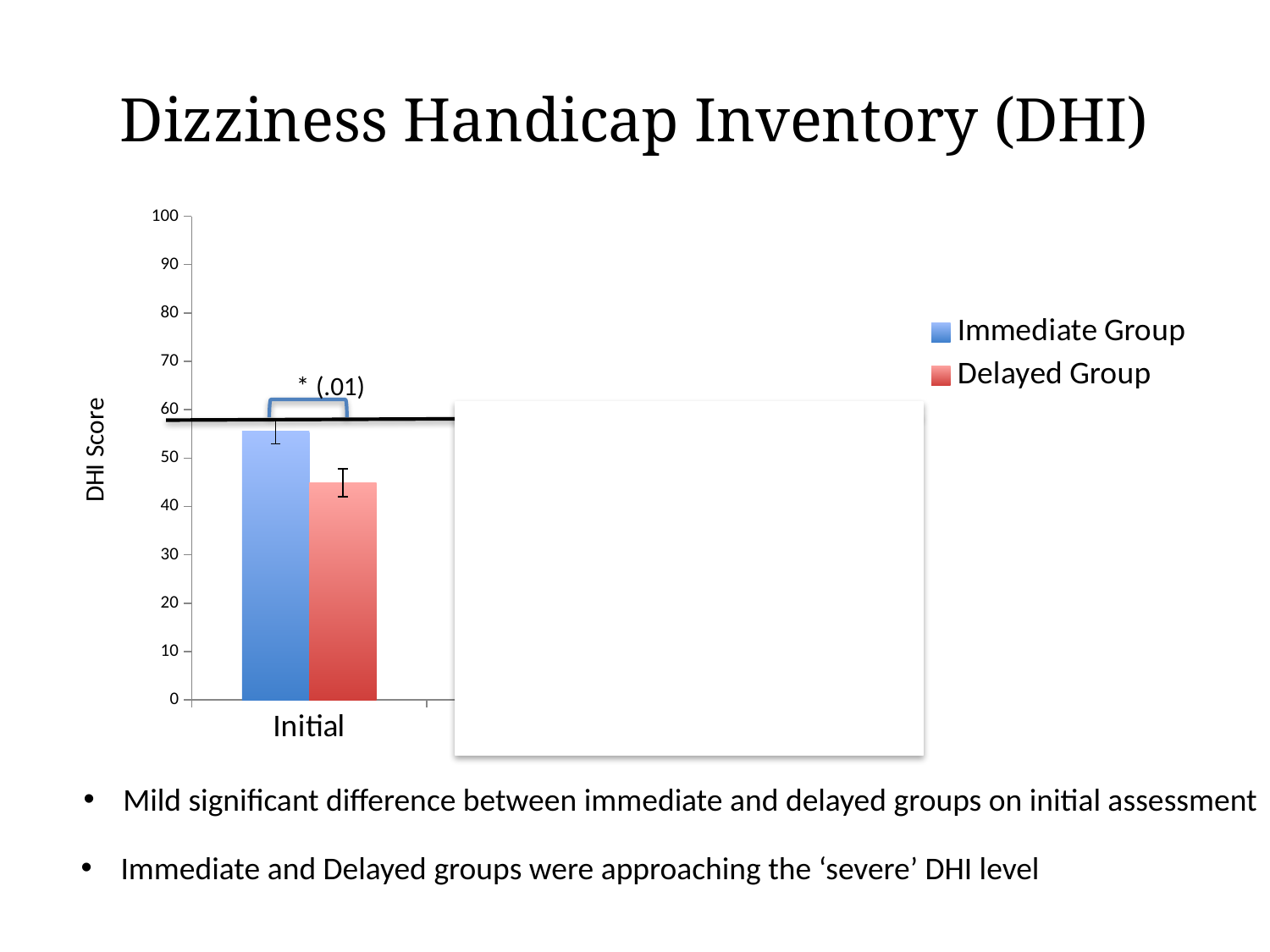
For the Initial assessment, which group has the higher DHI score, the Immediate Group or the Delayed Group? Immediate Group Is the Initial value for the Delayed Group greater or less than 40? greater What kind of chart is shown on the slide? bar chart What is the label of the y axis? DHI Score Is the Initial value for the Immediate Group greater or less than 60? less Is the Initial value for the Immediate Group greater or less than 50? greater Which group has the lowest bar at the Initial assessment? Delayed Group How many series does the legend list? 2 What is the highest value shown on the y axis? 100 What are the two series named in the legend? Immediate Group and Delayed Group